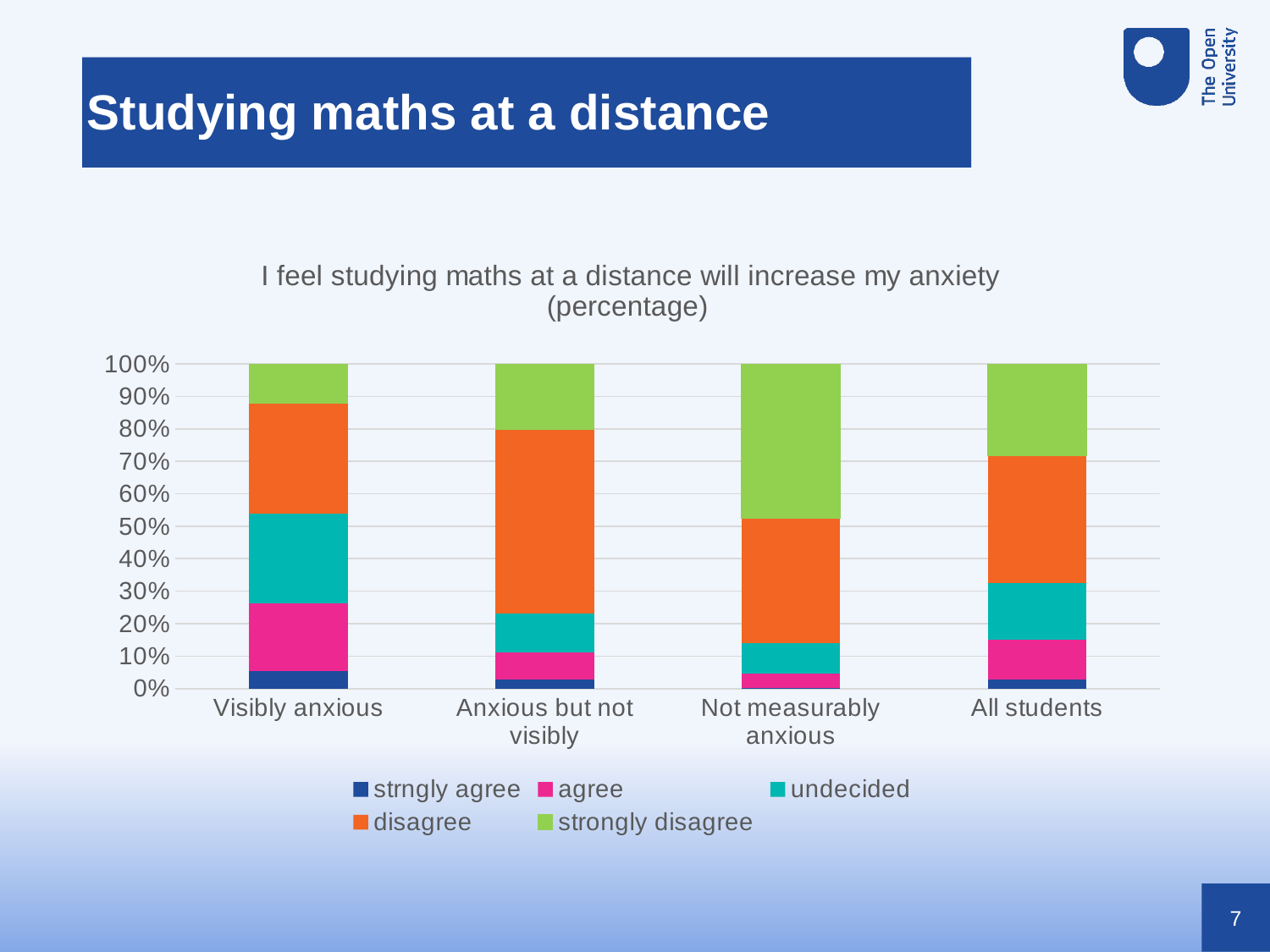
Which category has the largest 'undecided' segment? Visibly anxious What kind of chart is shown on the slide? stacked bar chart Is the 'agree' segment larger for Visibly anxious or for All students? Visibly anxious How many student categories are shown on the x axis? 4 What is the title of the chart? I feel studying maths at a distance will increase my anxiety (percentage) Is the 'undecided' share for Visibly anxious greater or less than 20%? greater Is the 'strongly disagree' share for Not measurably anxious greater or less than 40%? greater Is the 'agree' share for Not measurably anxious greater or less than 10%? less Which category has the largest 'strongly disagree' segment? Not measurably anxious How many series does the legend list? 5 Which category has the largest 'disagree' segment? Anxious but not visibly Which series is shown in orange in the legend? disagree